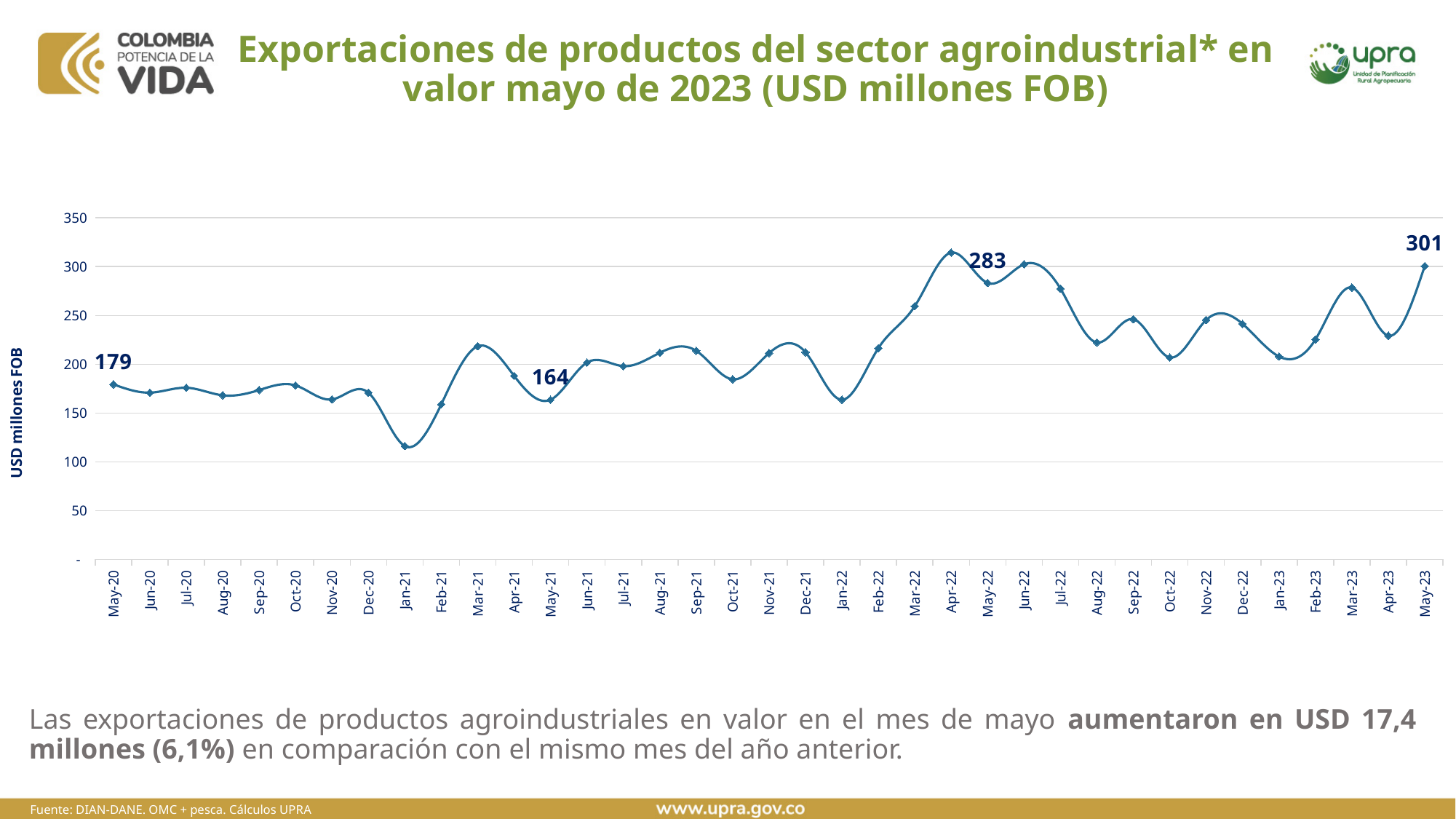
What is the value for May-20? 179 Is the value for Jan-21 greater or less than 150? less Is the value for Apr-22 greater or less than 300? greater What is the value for May-22? 283 Which month has the lowest value on the chart? Jan-21 What is the value for May-23? 301 How many monthly data points are plotted on the chart? 37 Which is larger, the value for May-21 or the value for May-22? May-22 What is the value for May-21? 164 What is the difference between the values for May-23 and May-22? 18 What kind of chart is shown on the slide? line chart What is the difference between the values for May-22 and May-21? 119